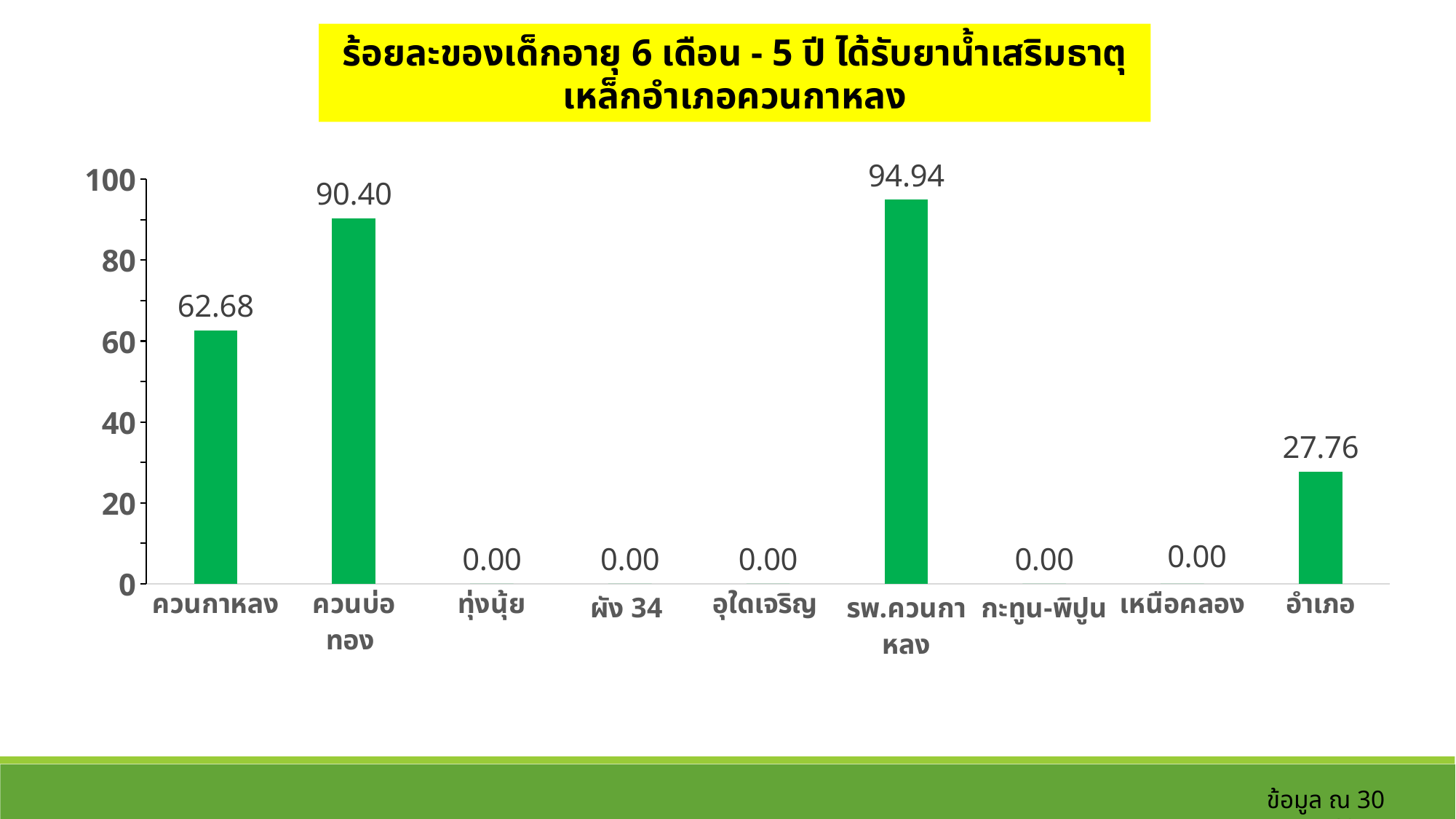
How many categories have a value of 0.00? 5 What is the value for อำเภอ? 27.76 What is the value for ควนกาหลง? 62.68 What kind of chart is shown on the slide? bar chart How many categories are shown on the x axis? 9 Is the value for อำเภอ greater or less than 40? less What is the value for ควนบ่อทอง? 90.40 Which category has the highest value? รพ.ควนกาหลง Which is larger, the value for ควนกาหลง or the value for อำเภอ? ควนกาหลง What is the value for รพ.ควนกาหลง? 94.94 What is the difference between the values for รพ.ควนกาหลง and ควนบ่อทอง? 4.54 What is the difference between the values for ควนบ่อทอง and ควนกาหลง? 27.72